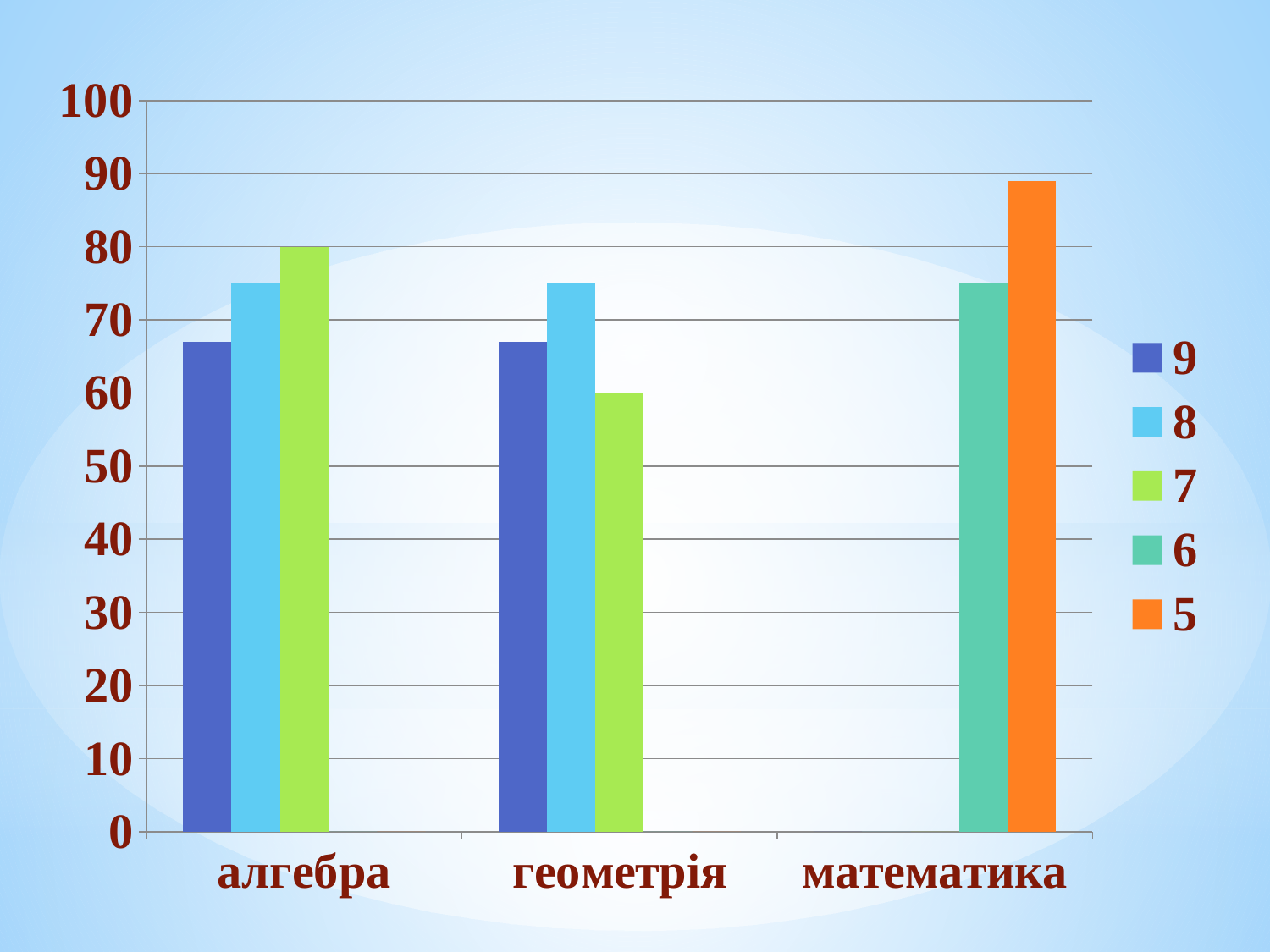
What is the value of series 7 for геометрія? 60 Which series is shown in orange in the legend? 5 How many series does the legend list? 5 What is the difference between the value of series 7 for алгебра and for геометрія? 20 Which category contains the tallest bar in the chart? математика Which series has the lowest bar in the геометрія category? 7 How many categories are shown on the x axis? 3 Is the value of series 5 for математика greater or less than 80? greater Is the value of series 9 for алгебра greater or less than 70? less What is the value of series 7 for алгебра? 80 What kind of chart is shown on the slide? bar chart Which is larger: series 7 for алгебра or series 7 for геометрія? алгебра